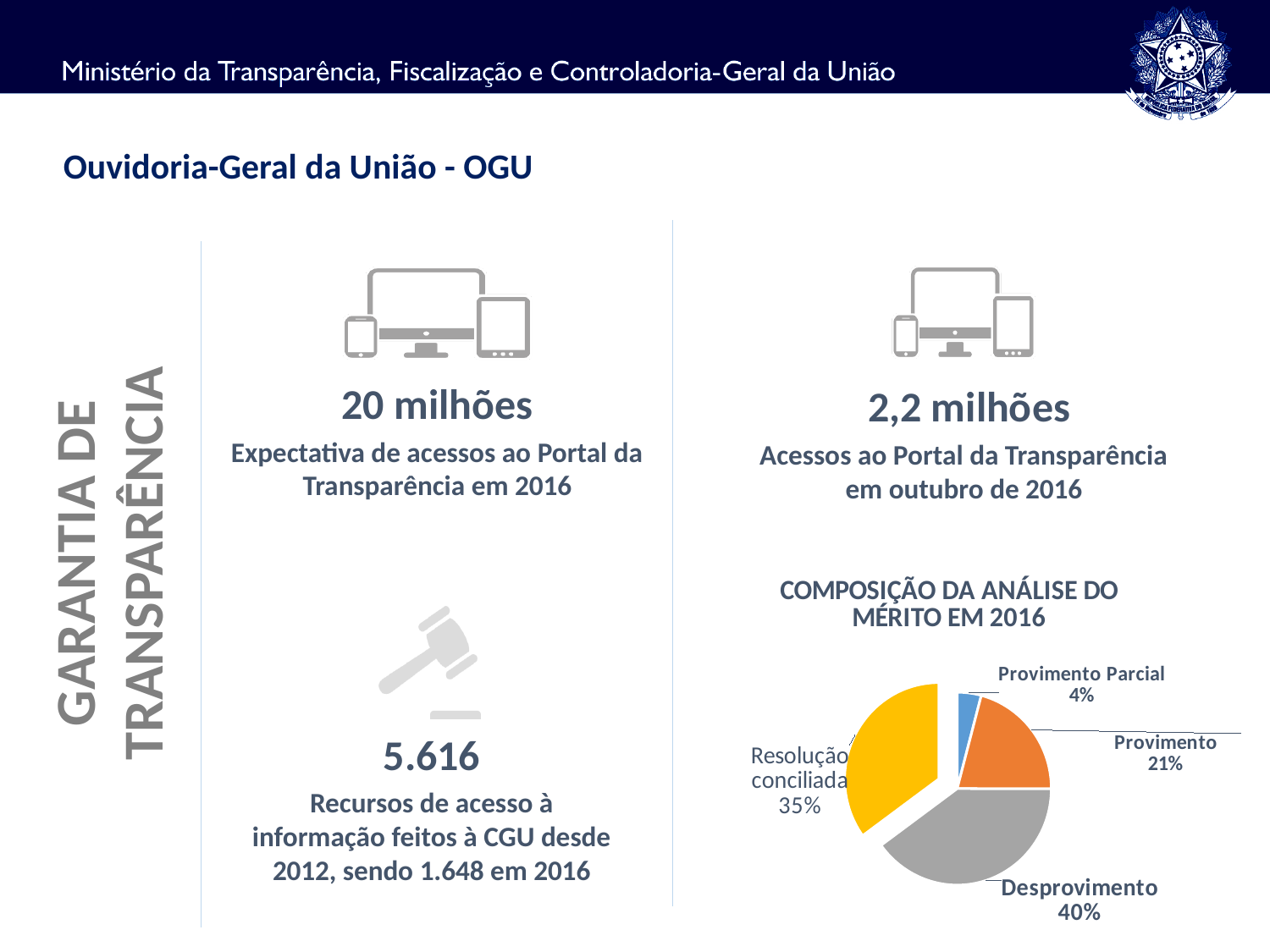
What is the title of the pie chart? COMPOSIÇÃO DA ANÁLISE DO MÉRITO EM 2016 What is the combined share of Provimento and Provimento Parcial? 25% What share of the pie does Desprovimento represent? 40% Which category has the largest slice of the pie? Desprovimento What kind of chart is shown on the slide? pie chart What share of the pie does Provimento Parcial represent? 4% How many slices does the pie chart have? 4 What is the difference in percentage points between Desprovimento and Provimento? 19 What share of the pie does Provimento represent? 21% Which is larger, Resolução conciliada or Provimento? Resolução conciliada Which category has the smallest slice of the pie? Provimento Parcial What share of the pie does Resolução conciliada represent? 35%